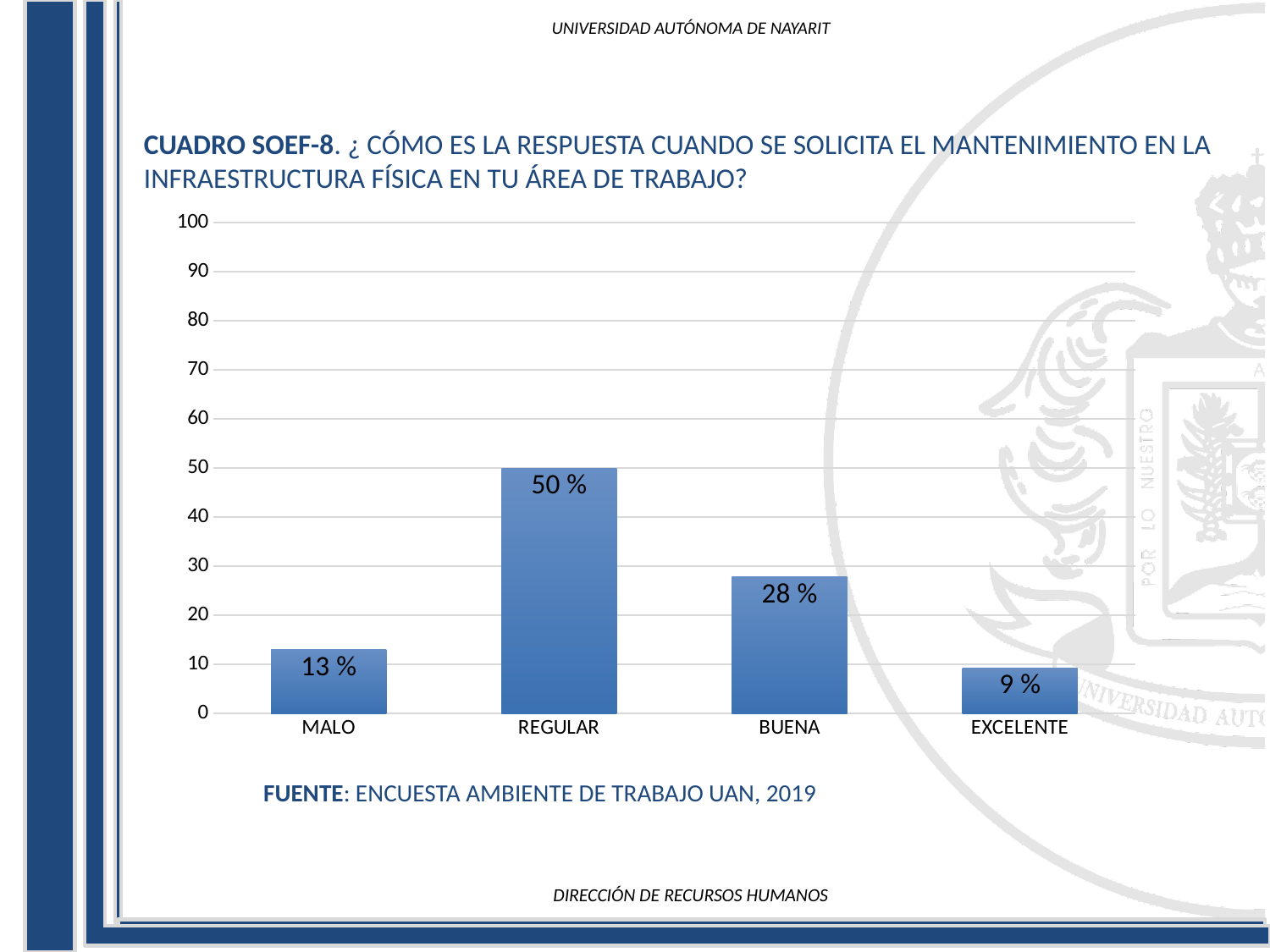
What kind of chart is shown on the slide? bar chart What is the value for REGULAR? 50 % Is the value for BUENA greater or less than 30? less What is the value for MALO? 13 % What source is cited below the chart? ENCUESTA AMBIENTE DE TRABAJO UAN, 2019 What is the highest value shown on the y axis? 100 What is the value for EXCELENTE? 9 % Which is larger, the value for MALO or the value for BUENA? BUENA Which category has the highest value? REGULAR Which category has the lowest value? EXCELENTE What is the difference between the values for REGULAR and BUENA? 22 % How many categories are shown on the x axis? 4